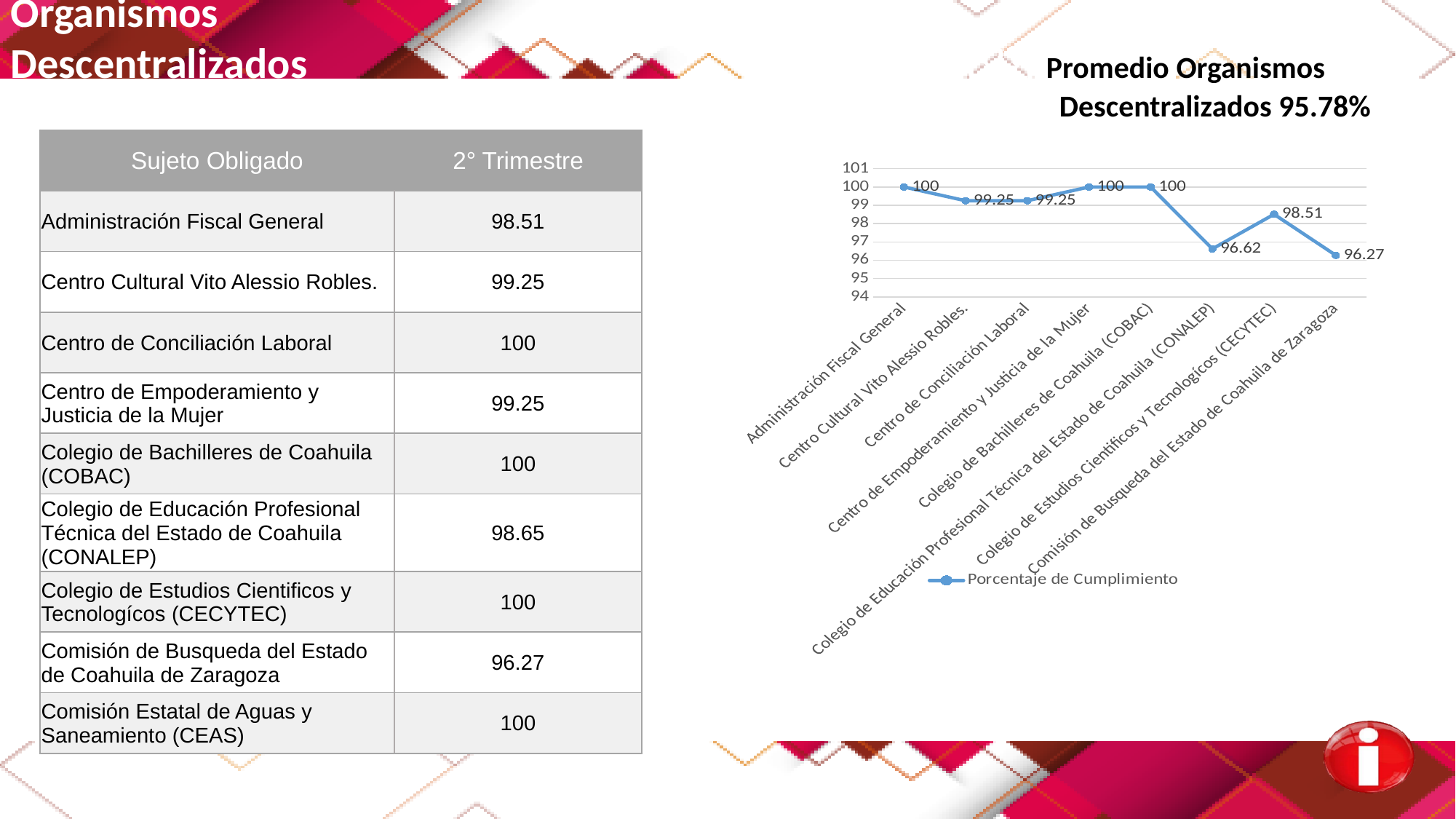
In the line chart, what is the value for Colegio de Estudios Cientificos y Tecnologícos (CECYTEC)? 98.51 In the line chart, what is the difference between the values for Colegio de Estudios Cientificos y Tecnologícos (CECYTEC) and Colegio de Educación Profesional Técnica del Estado de Coahuila (CONALEP)? 1.89 In the line chart, what is the value for Colegio de Educación Profesional Técnica del Estado de Coahuila (CONALEP)? 96.62 In the line chart, what is the value for Comisión de Busqueda del Estado de Coahuila de Zaragoza? 96.27 How many series does the legend of the line chart list? 1 What kind of chart is shown on the right side of the slide? Line chart In the line chart, which category has the lowest value? Comisión de Busqueda del Estado de Coahuila de Zaragoza How many categories are plotted in the line chart? 8 In the line chart, which is larger: the value for Centro de Conciliación Laboral or the value for Colegio de Bachilleres de Coahuila (COBAC)? Colegio de Bachilleres de Coahuila (COBAC) In the line chart, is the value for Comisión de Busqueda del Estado de Coahuila de Zaragoza greater or less than 97? less In the line chart, what is the value for Centro Cultural Vito Alessio Robles.? 99.25 What is the name of the series shown in the legend of the line chart? Porcentaje de Cumplimiento